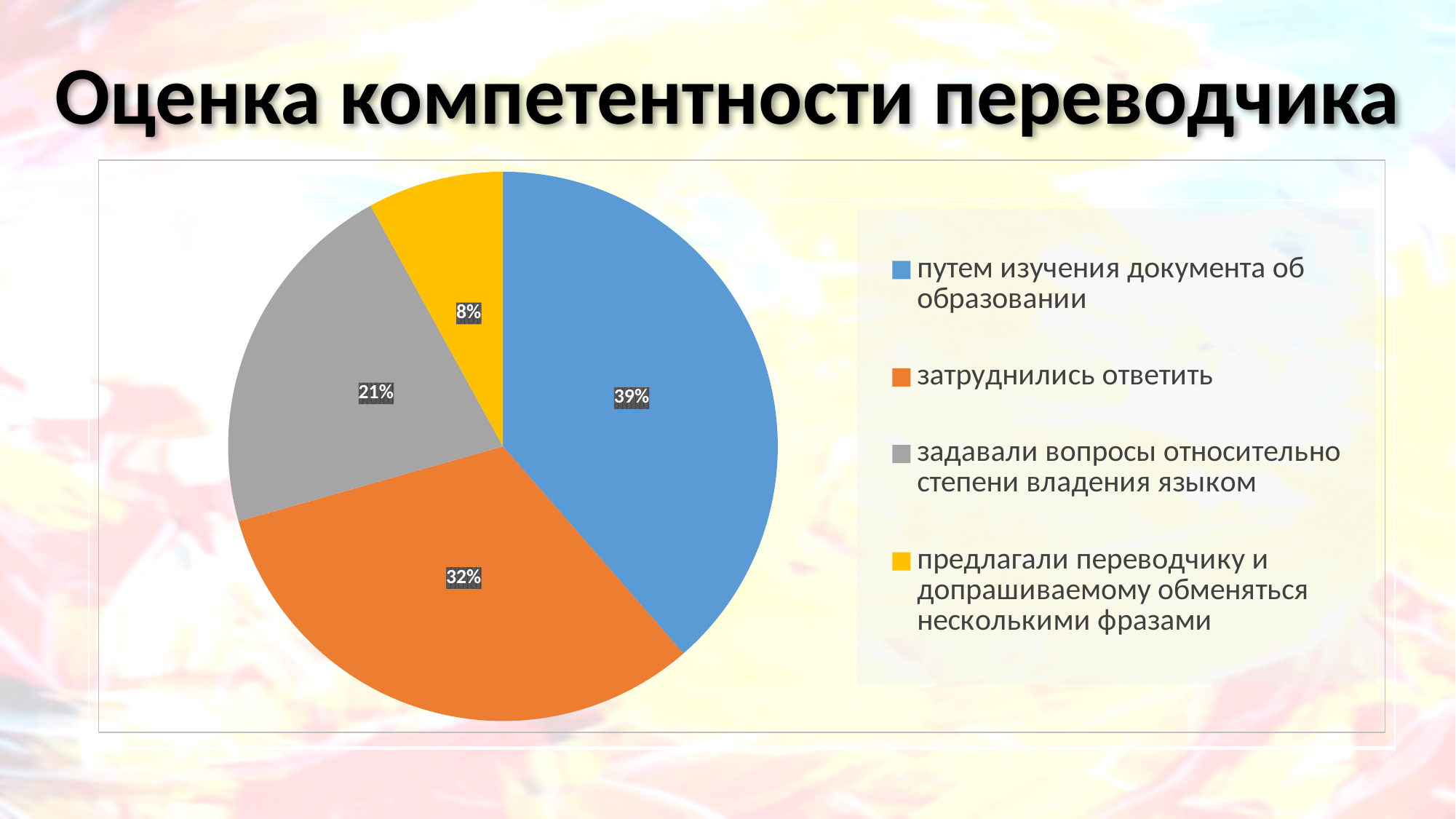
What is the difference in percentage points between 'путем изучения документа об образовании' and 'затруднились ответить'? 7 Which category has the largest slice of the pie? путем изучения документа об образовании What share of the pie is labelled 'затруднились ответить'? 32% What share of the pie is labelled 'путем изучения документа об образовании'? 39% What is the title of the slide containing the chart? Оценка компетентности переводчика What type of chart is shown on the slide? pie chart Which is larger: the slice for 'задавали вопросы относительно степени владения языком' or the slice for 'предлагали переводчику и допрашиваемому обменяться несколькими фразами'? задавали вопросы относительно степени владения языком How many slices does the pie chart have? 4 What share of the pie is labelled 'предлагали переводчику и допрашиваемому обменяться несколькими фразами'? 8% What colour is the slice for 'затруднились ответить'? orange What share of the pie is labelled 'задавали вопросы относительно степени владения языком'? 21% Which category has the smallest slice of the pie? предлагали переводчику и допрашиваемому обменяться несколькими фразами